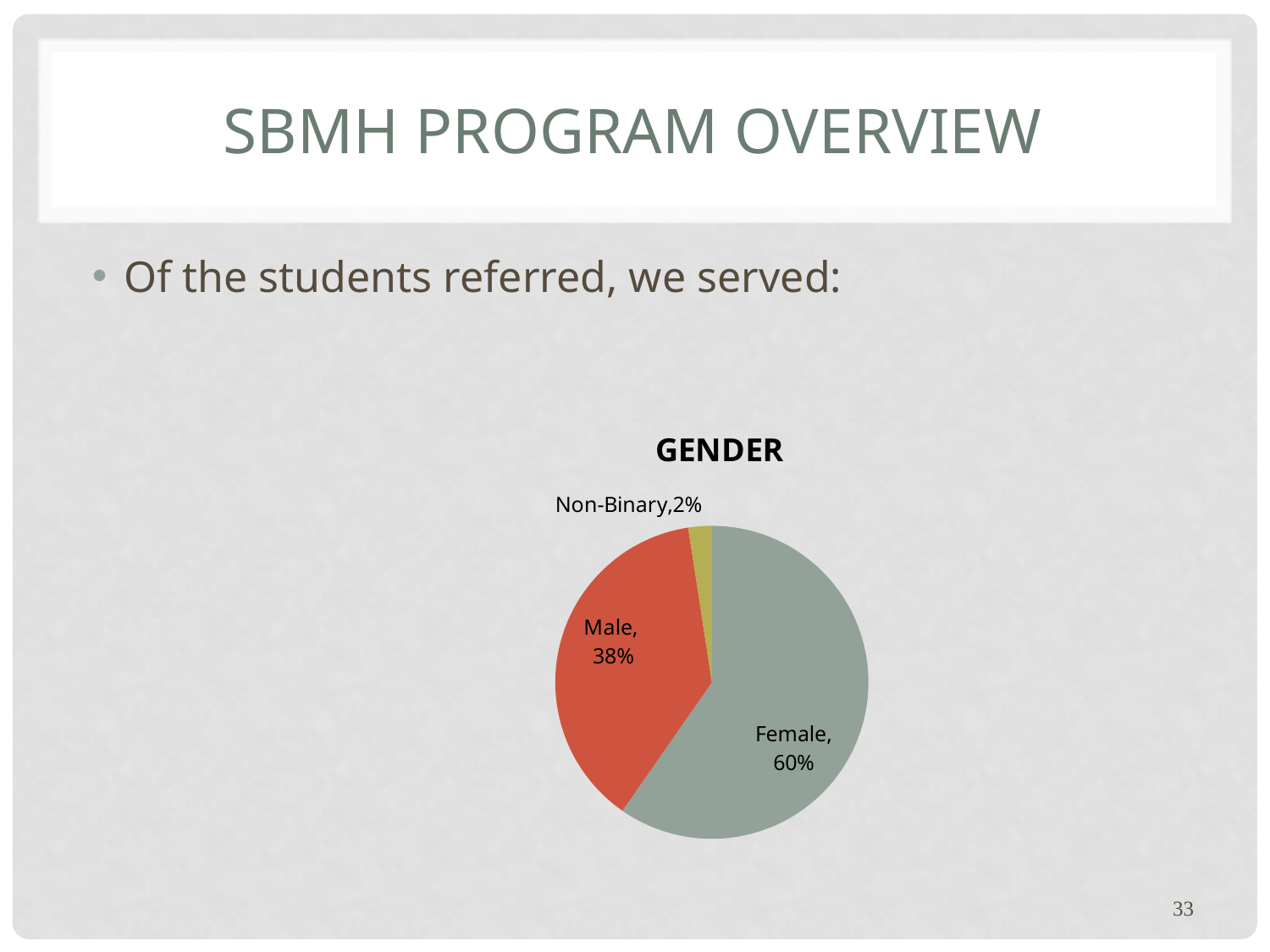
What percentage of students served were Non-Binary? 2% What is the title of the chart? GENDER Which category has the smallest share of the pie? Non-Binary What percentage of students served were Female? 60% What is the difference in percentage points between the Male and Non-Binary shares? 36 What type of chart is shown on the slide? pie chart What is the difference in percentage points between the Female and Male shares? 22 Which category has the largest share of the pie? Female How many categories are shown in the pie chart? 3 Which is larger, the Male share or the Female share? Female What percentage of students served were Male? 38% What colour is the Male slice of the pie? red